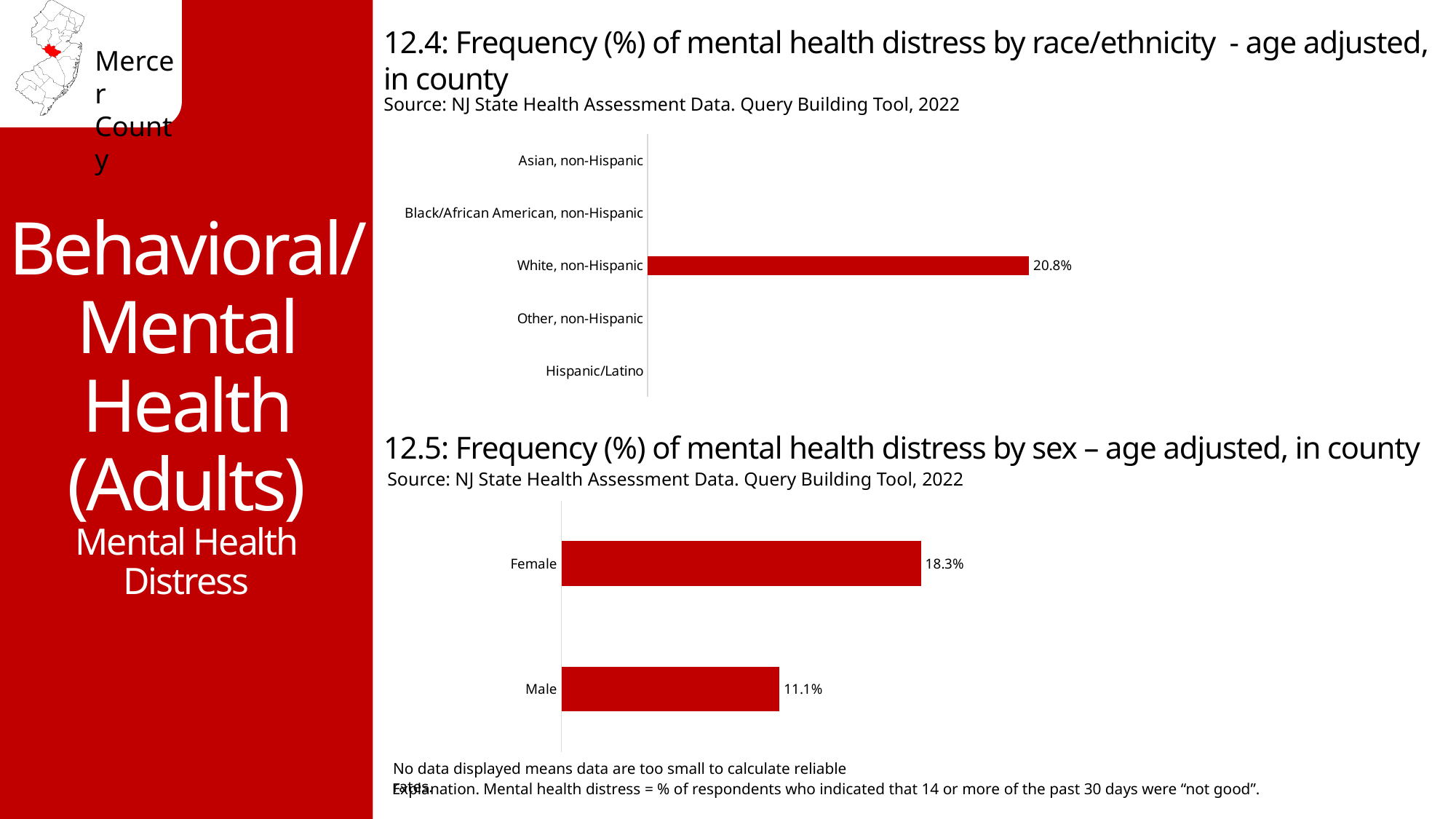
What kind of chart is chart 12.4 (mental health distress by race/ethnicity)? Bar chart In the chart 12.4 (mental health distress by race/ethnicity), which category is the only one with a bar displayed? White, non-Hispanic What kind of chart is chart 12.5 (mental health distress by sex)? Bar chart What is the source cited for chart 12.4 (mental health distress by race/ethnicity)? NJ State Health Assessment Data. Query Building Tool, 2022 In the chart 12.5 (mental health distress by sex), how many categories are shown? 2 In the chart 12.5 (mental health distress by sex), what is the difference between the Female and Male values? 7.2% In the chart 12.4 (mental health distress by race/ethnicity), how many race/ethnicity categories are listed on the axis? 5 In the chart 12.5 (mental health distress by sex), which category has the higher value? Female In the chart 12.5 (mental health distress by sex), what is the value for Male? 11.1% In the chart 12.4 (mental health distress by race/ethnicity), what is the value for White, non-Hispanic? 20.8% In the chart 12.5 (mental health distress by sex), what is the value for Female? 18.3% In the chart 12.5 (mental health distress by sex), which category has the lower value? Male